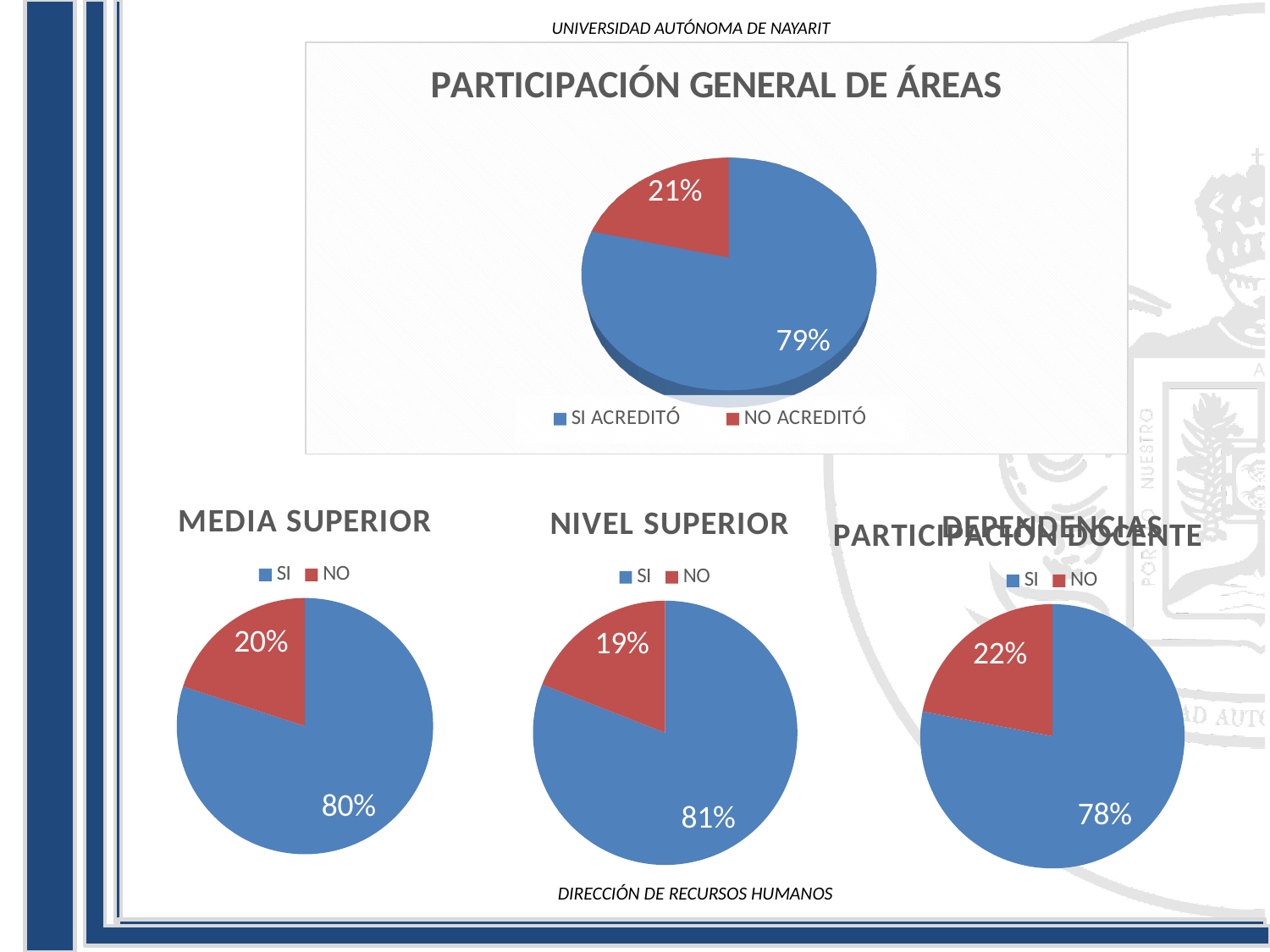
What kind of chart is the PARTICIPACIÓN GENERAL DE ÁREAS chart? Pie chart In the NIVEL SUPERIOR chart, what share of the pie is SI? 81% In the NIVEL SUPERIOR chart, what is the difference between the SI and NO shares? 62% In the bottom-right pie chart, what share of the pie is NO? 22% In the PARTICIPACIÓN GENERAL DE ÁREAS chart, what share of the pie is SI ACREDITÓ? 79% In the MEDIA SUPERIOR chart, which slice is larger, SI or NO? SI How many entries does the legend of the PARTICIPACIÓN GENERAL DE ÁREAS chart list? 2